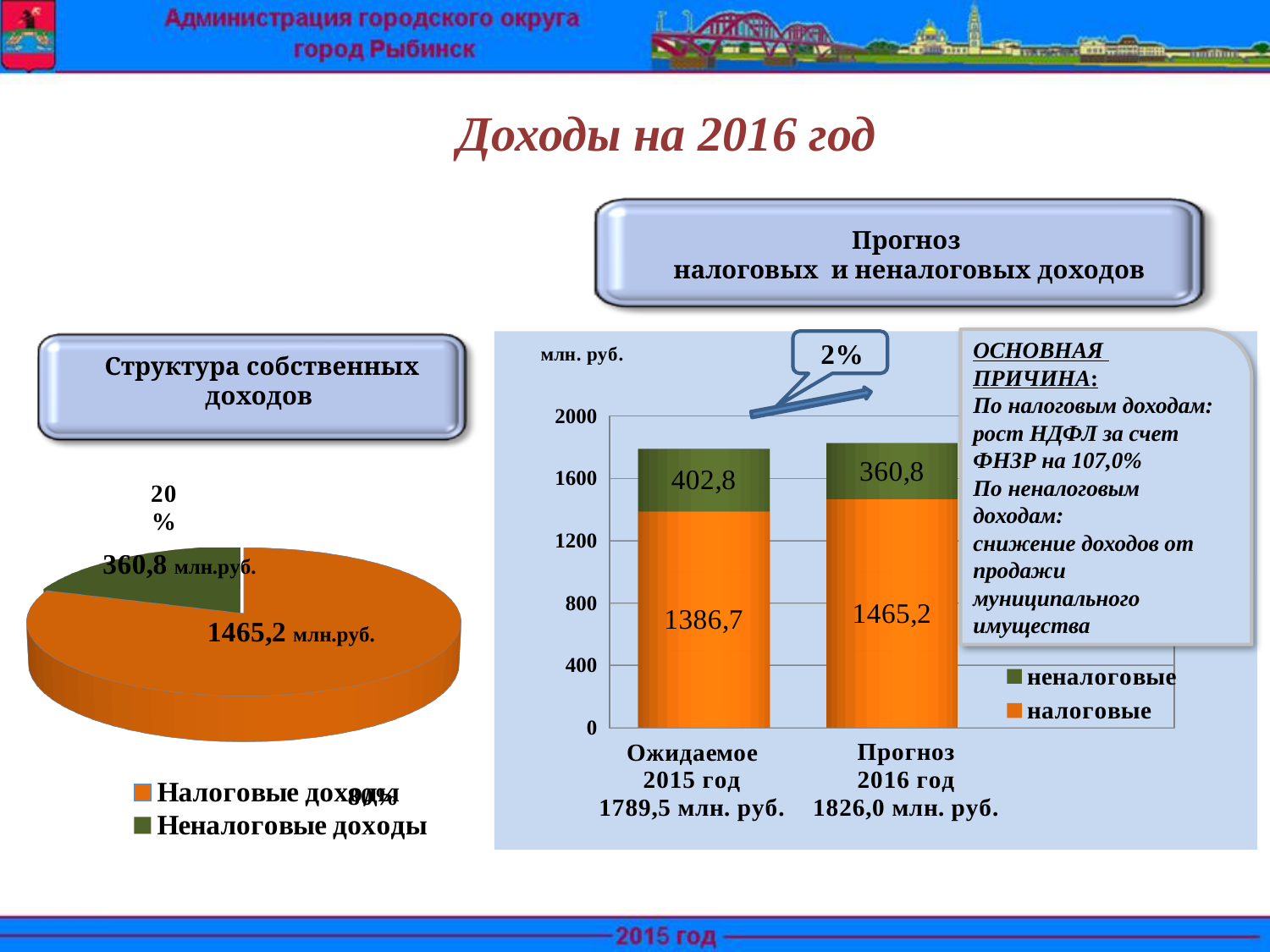
On the left chart 'Структура собственных доходов', what share of the pie is Неналоговые доходы? 20% What kind of chart is the left chart 'Структура собственных доходов'? pie chart On the right chart 'Прогноз налоговых и неналоговых доходов', what is the value for неналоговые in Прогноз 2016 год? 360,8 On the left chart 'Структура собственных доходов', what is the value for Налоговые доходы? 1465,2 млн.руб. On the left chart 'Структура собственных доходов', what is the value for Неналоговые доходы? 360,8 млн.руб. On the right chart 'Прогноз налоговых и неналоговых доходов', what is the total of the stacked bar for Прогноз 2016 год? 1826,0 млн. руб. On the right chart 'Прогноз налоговых и неналоговых доходов', what is the value for налоговые in Ожидаемое 2015 год? 1386,7 What kind of chart is the right chart 'Прогноз налоговых и неналоговых доходов'? stacked bar chart On the right chart 'Прогноз налоговых и неналоговых доходов', how many categories are shown on the x axis? 2 On the right chart 'Прогноз налоговых и неналоговых доходов', what is the difference between the налоговые values for Прогноз 2016 год and Ожидаемое 2015 год? 78,5 On the right chart 'Прогноз налоговых и неналоговых доходов', how many series does the legend list? 2 On the right chart 'Прогноз налоговых и неналоговых доходов', which is larger: неналоговые in Ожидаемое 2015 год or неналоговые in Прогноз 2016 год? Ожидаемое 2015 год